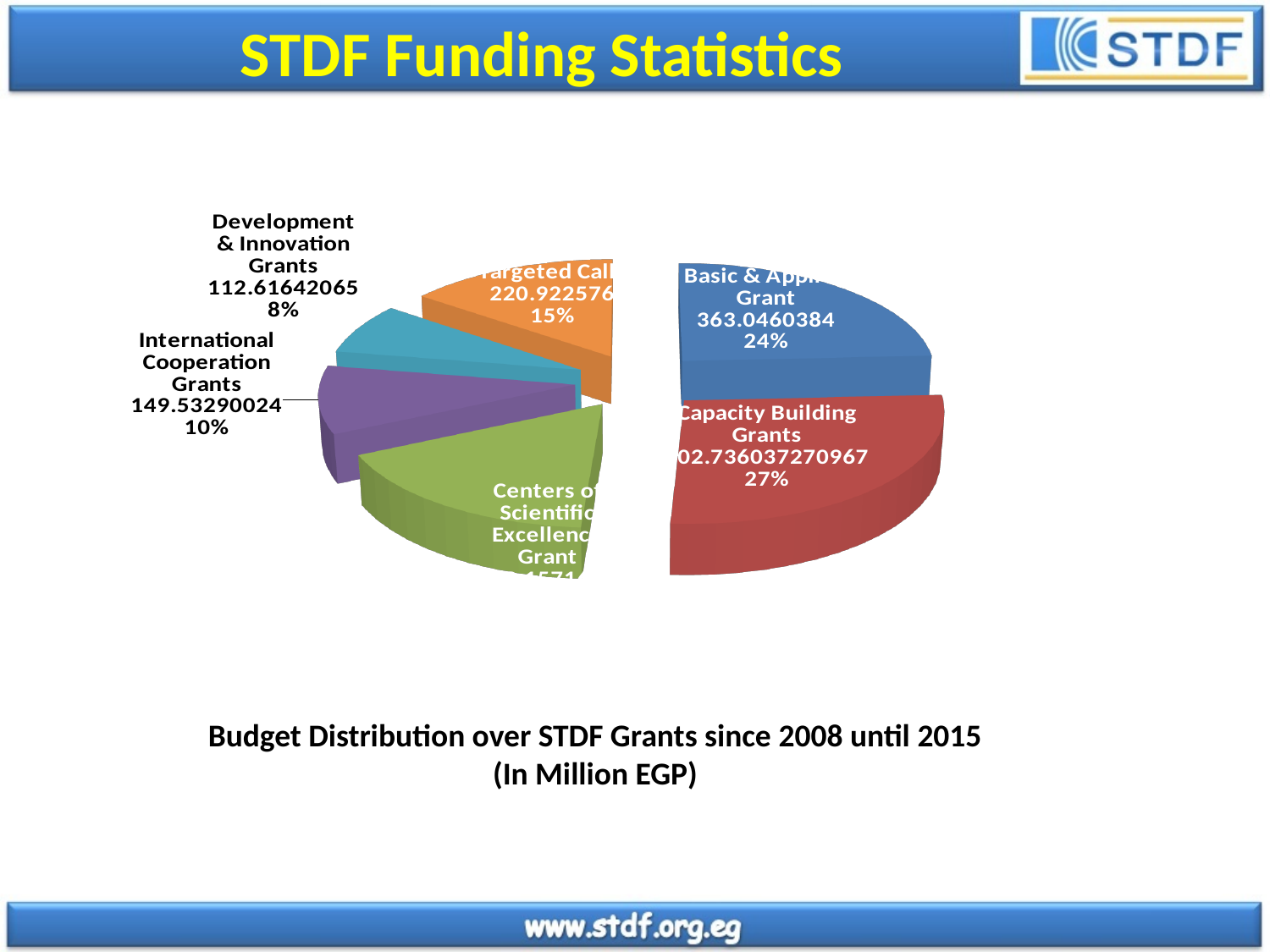
What is the value for Development & Innovation Grants? 112.61642065 What is the difference between the values for International Cooperation Grants and Development & Innovation Grants? 36.91647959 What percentage share of the pie does Capacity Building Grants have? 27% What percentage share of the pie does Targeted Call have? 15% What is the value for Targeted Call? 220.922576 Which is larger, the value for Targeted Call or the value for International Cooperation Grants? Targeted Call In what unit are the values in the chart expressed, according to the caption below it? Million EGP Which category has the smallest share of the pie? Development & Innovation Grants Which category has the largest share of the pie? Capacity Building Grants What is the value for International Cooperation Grants? 149.53290024 How many slices does the pie chart have? 6 What kind of chart is shown on the slide? Pie chart